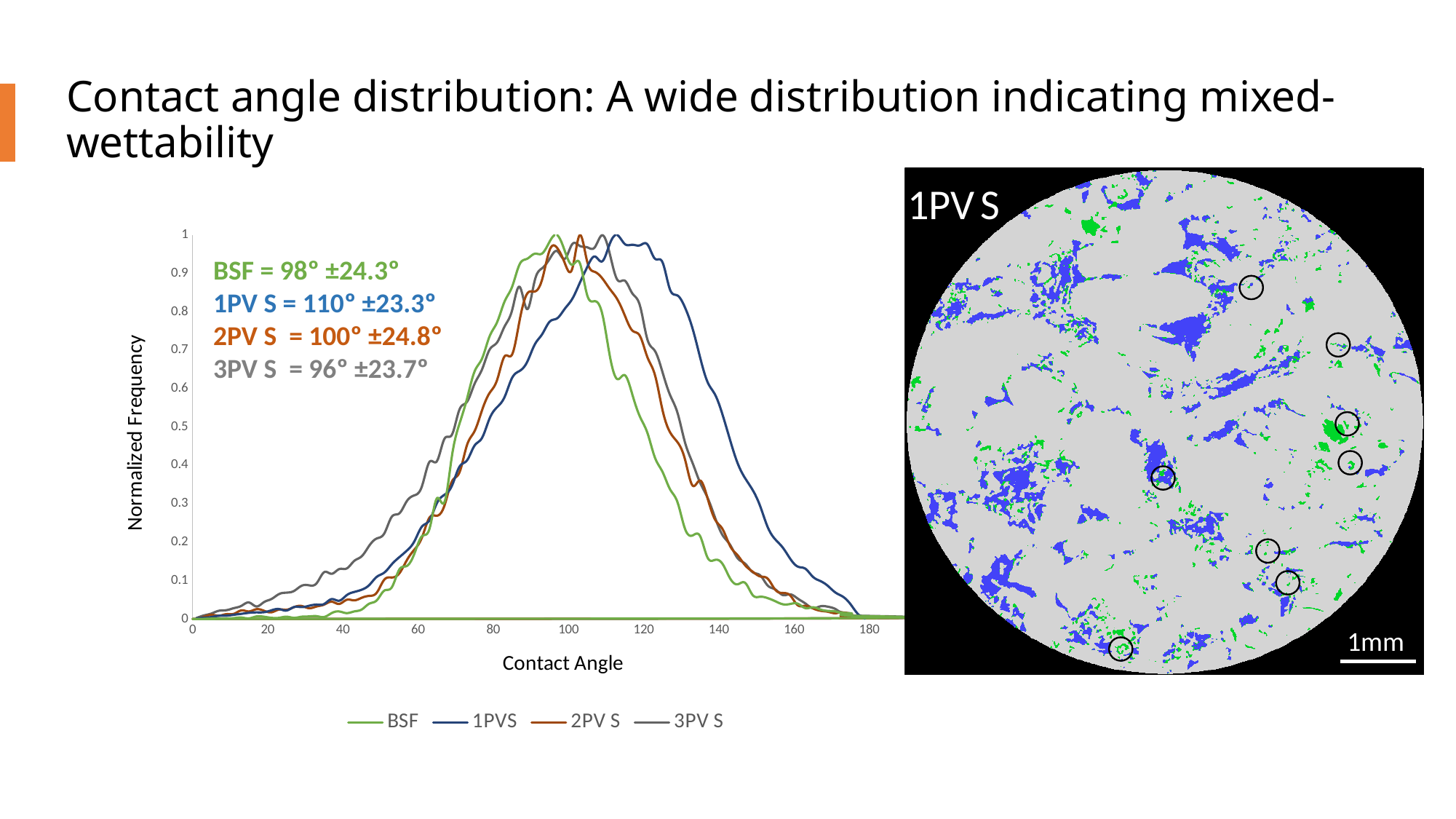
Is the normalized frequency of the BSF series at a contact angle of 140 greater or less than 0.5? less How many series does the legend of the contact angle chart list? 4 What is the difference between the mean contact angles of 1PV S and 3PV S shown in the annotations? 14° Which series has the lowest mean contact angle according to the annotations on the chart? 3PV S Which series has the highest mean contact angle according to the annotations on the chart? 1PV S Does the BSF curve rise or fall as the contact angle increases from 100 to 140? fall What is the label of the x axis of the chart? Contact Angle What kind of chart is shown on the slide? line chart According to the annotation on the chart, what is the mean contact angle for 3PV S? 96° ±23.7° What is the label of the y axis of the chart? Normalized Frequency According to the annotation on the chart, what is the mean contact angle for 1PV S? 110° ±23.3° According to the annotation on the chart, what is the mean contact angle for BSF? 98° ±24.3°